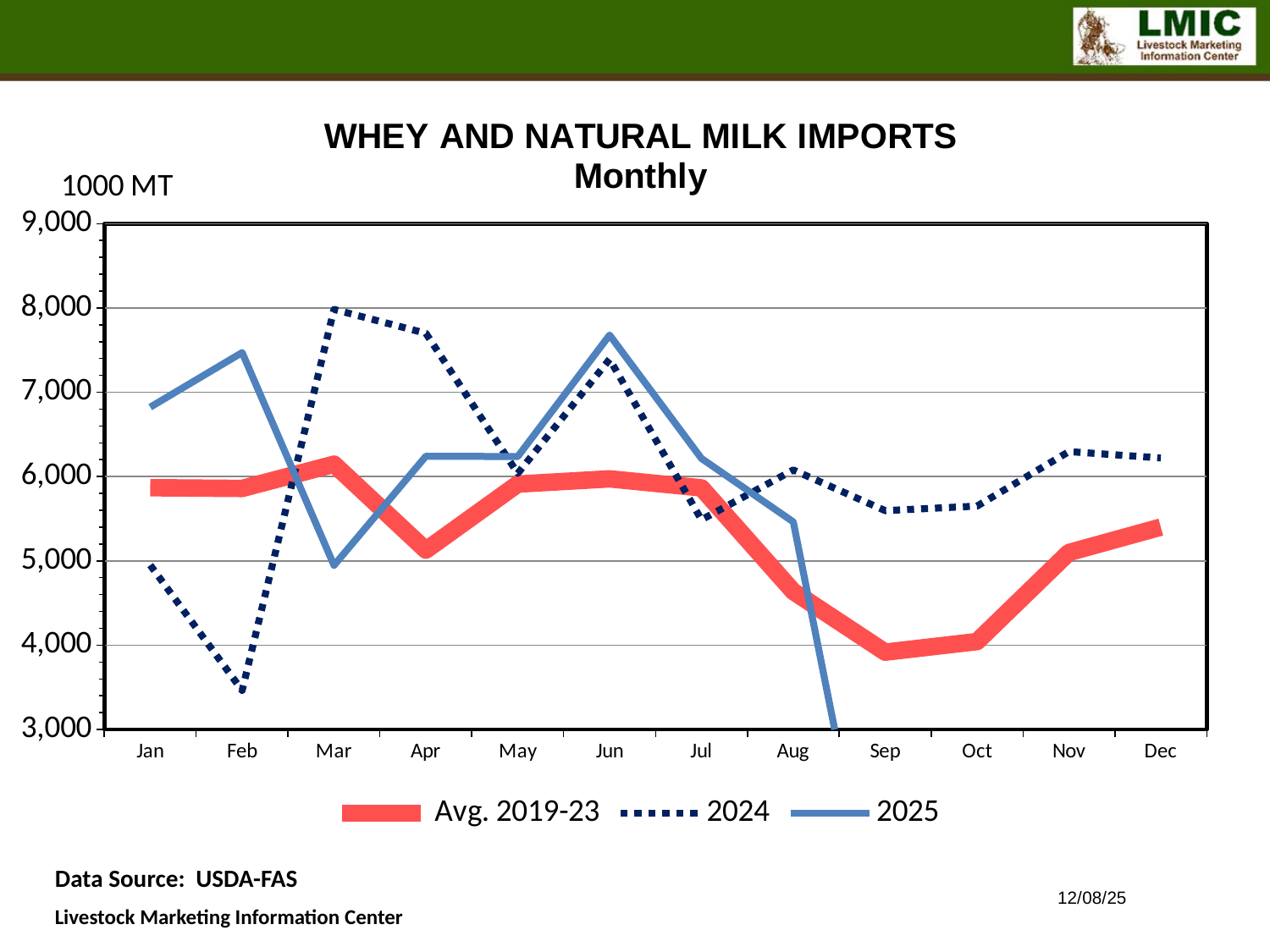
How many months are shown on the x axis? 12 What kind of chart is shown on the slide? line chart Is the value for 2025 in Feb greater or less than 7,000? greater Does the Avg. 2019-23 series rise or fall from Sep to Dec? rise In Jan, which series has the larger value, 2024 or 2025? 2025 How many series does the legend list? 3 Is the value for Avg. 2019-23 in Sep greater or less than 5,000? less In which month is the 2024 series at its highest? Mar Is the value for 2024 in Nov greater or less than 6,000? greater What unit is shown for the y axis? 1000 MT In which month is the 2024 series at its lowest? Feb